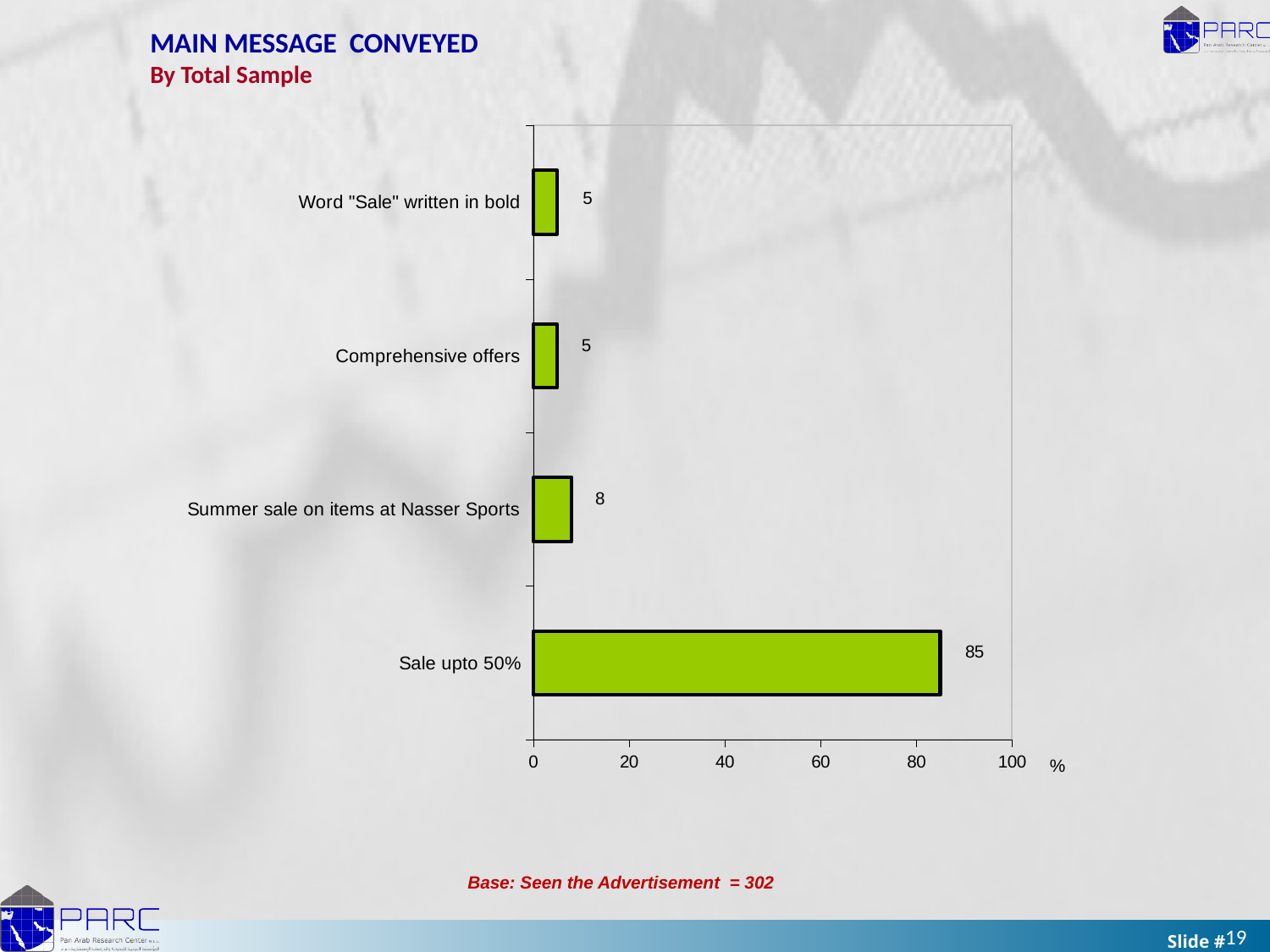
What is the base stated below the chart? Seen the Advertisement = 302 What is the value for "Sale upto 50%"? 85 What is the value for "Word "Sale" written in bold"? 5 What kind of chart is shown on the slide? bar chart How many categories are shown in the chart? 4 What unit is shown at the end of the x axis? % Is the value for "Sale upto 50%" greater or less than 80? greater What is the difference between the values for "Sale upto 50%" and "Summer sale on items at Nasser Sports"? 77 Which is larger, the value for "Summer sale on items at Nasser Sports" or the value for "Comprehensive offers"? Summer sale on items at Nasser Sports Which category has the highest value? Sale upto 50% What is the value for "Summer sale on items at Nasser Sports"? 8 What is the value for "Comprehensive offers"? 5